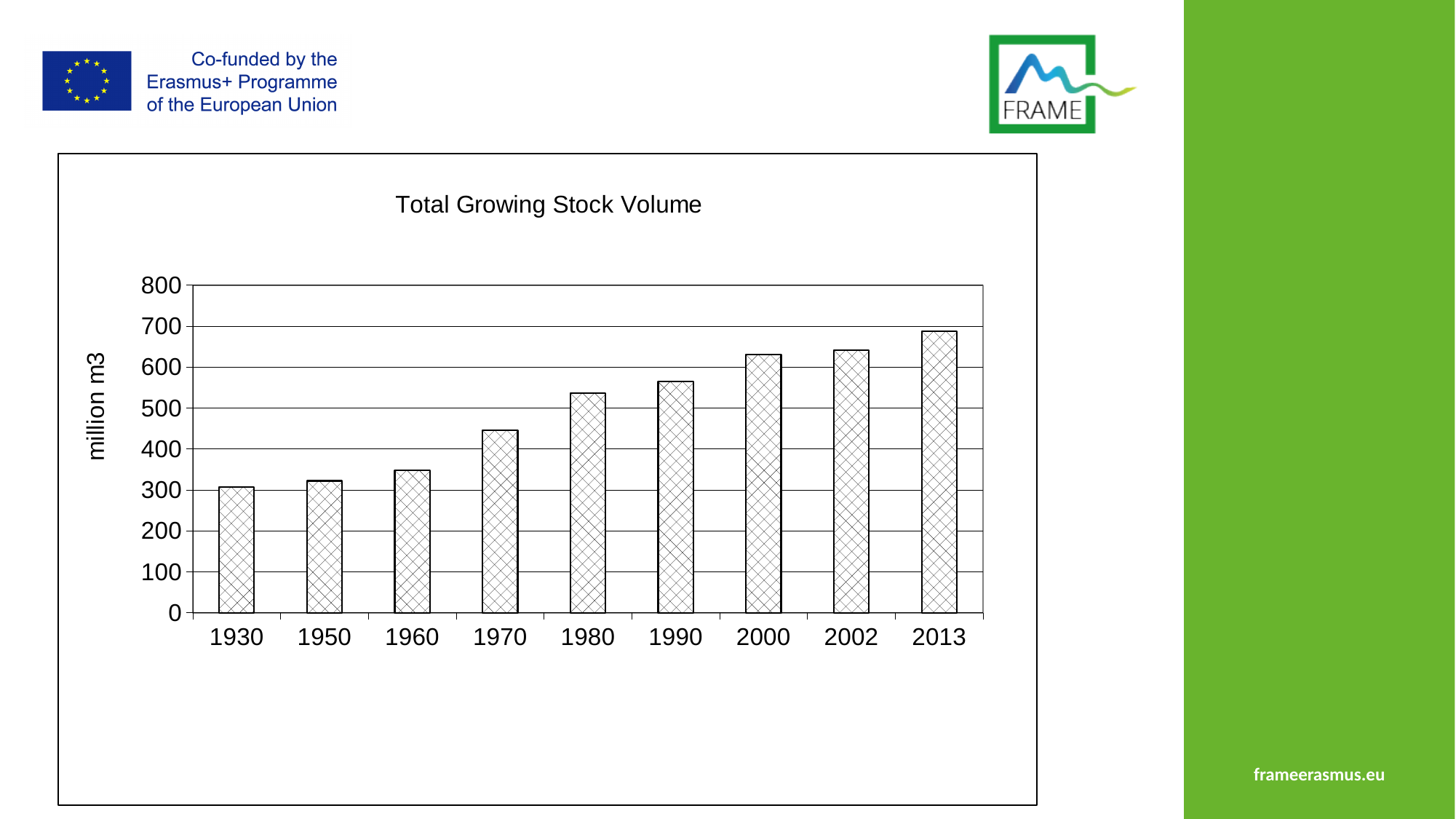
Which year has the lowest total growing stock volume? 1930 Is the value for 2013 greater or less than 700? less Do the values rise or fall from 1930 to 2013? rise Which year has the highest total growing stock volume? 2013 Is the value for 1930 greater or less than 400? less How many years are shown on the x axis of the chart? 9 Is the value for 1980 greater or less than 500? greater What unit is shown on the y axis label? million m3 Which is larger, the value for 1960 or the value for 1990? 1990 What type of chart is shown on the slide? bar chart What is the title of the chart? Total Growing Stock Volume